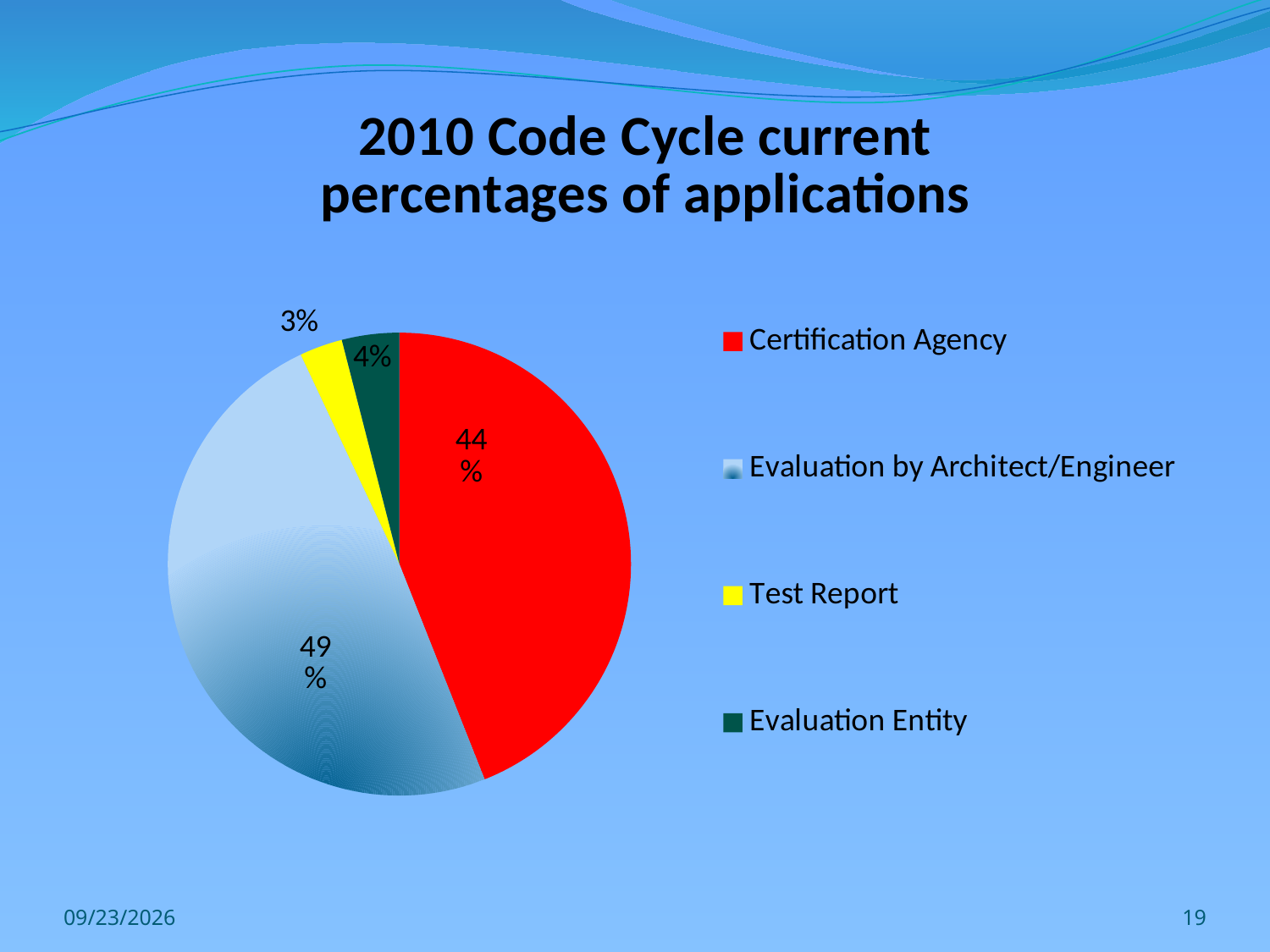
What percentage of applications is shown for Test Report? 3% How many categories does the pie chart show? 4 What percentage of applications is shown for Evaluation Entity? 4% What is the title of the chart? 2010 Code Cycle current percentages of applications What colour represents Test Report in the pie chart? yellow What percentage of applications is shown for Evaluation by Architect/Engineer? 49% What percentage of applications is shown for Certification Agency? 44% Which is larger, the share for Evaluation Entity or the share for Test Report? Evaluation Entity Which category has the smallest share of the pie? Test Report What type of chart is shown on the slide? pie chart What is the difference in percentage points between Evaluation by Architect/Engineer and Certification Agency? 5 Which category has the largest share of the pie? Evaluation by Architect/Engineer